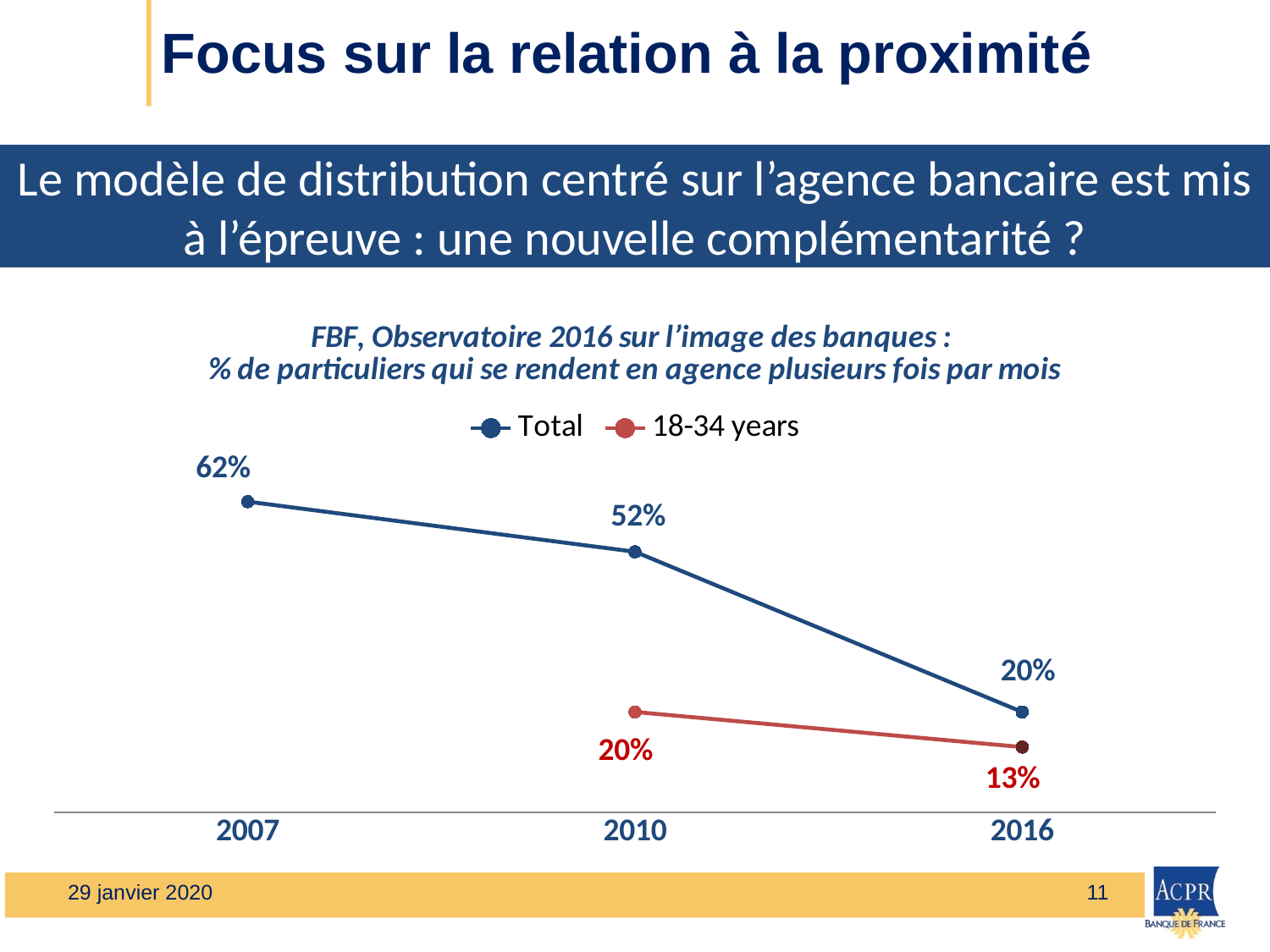
Which is larger in 2016, the Total value or the 18-34 years value? Total What is the value for 18-34 years in 2010? 20% In which year is the Total series lowest? 2016 What is the value for 18-34 years in 2016? 13% How many series does the legend list? 2 What is the value for Total in 2010? 52% What is the difference between the Total values for 2007 and 2016? 42% What is the value for Total in 2016? 20% In which year is the Total series highest? 2007 Does the Total series rise or fall from 2007 to 2016? Fall What kind of chart is shown on the slide? Line chart What is the value for Total in 2007? 62%